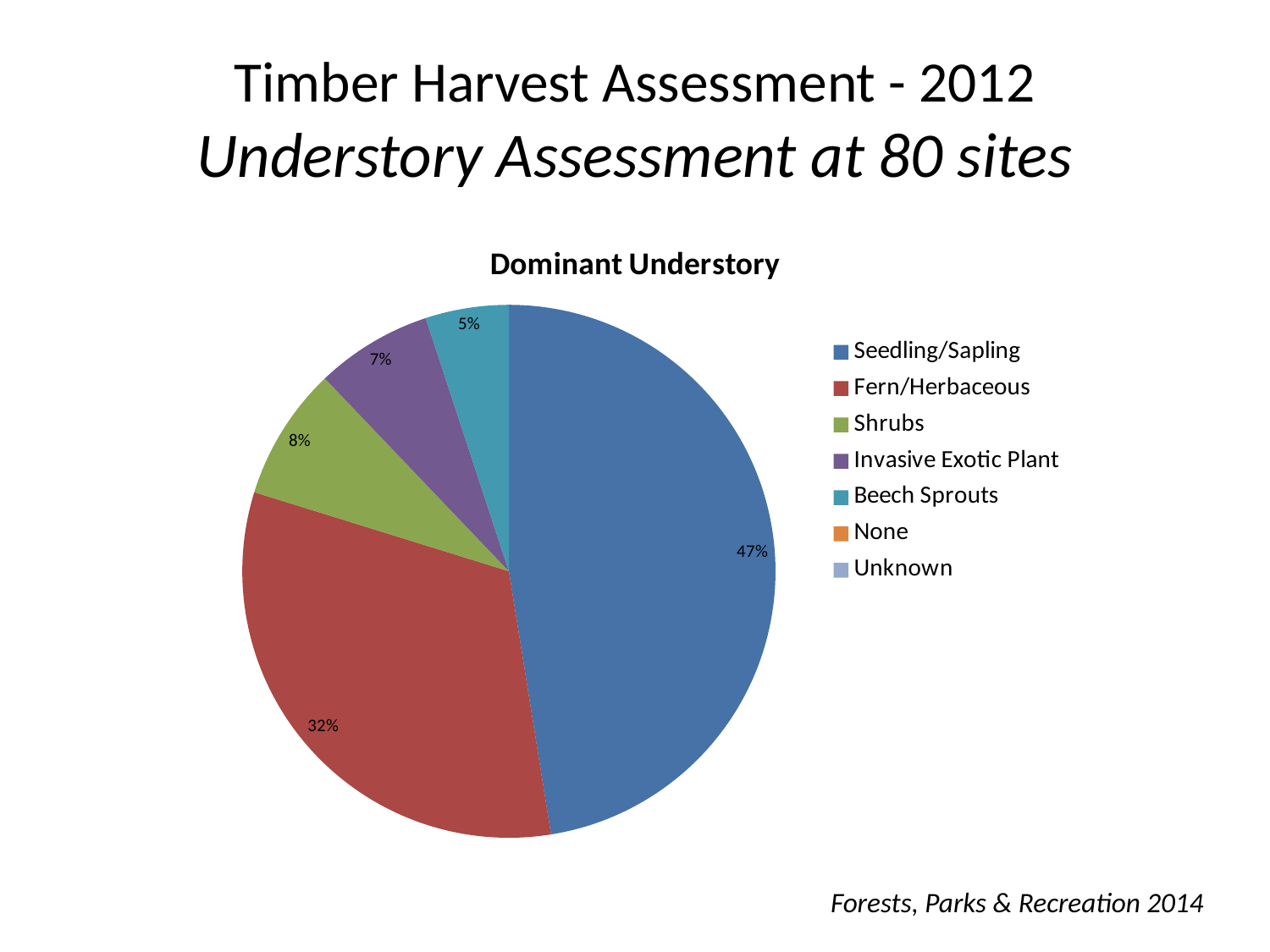
What is the title of the chart? Dominant Understory What colour is the Fern/Herbaceous slice? Red Which is larger, the share for Shrubs or the share for Beech Sprouts? Shrubs What share of the pie does Invasive Exotic Plant represent? 7% What share of the pie does Beech Sprouts represent? 5% What type of chart is shown on the slide? Pie chart How many entries does the legend list? 7 What share of the pie does Seedling/Sapling represent? 47% What is the difference between the Seedling/Sapling share and the Fern/Herbaceous share? 15% Which category has the largest share of the pie? Seedling/Sapling